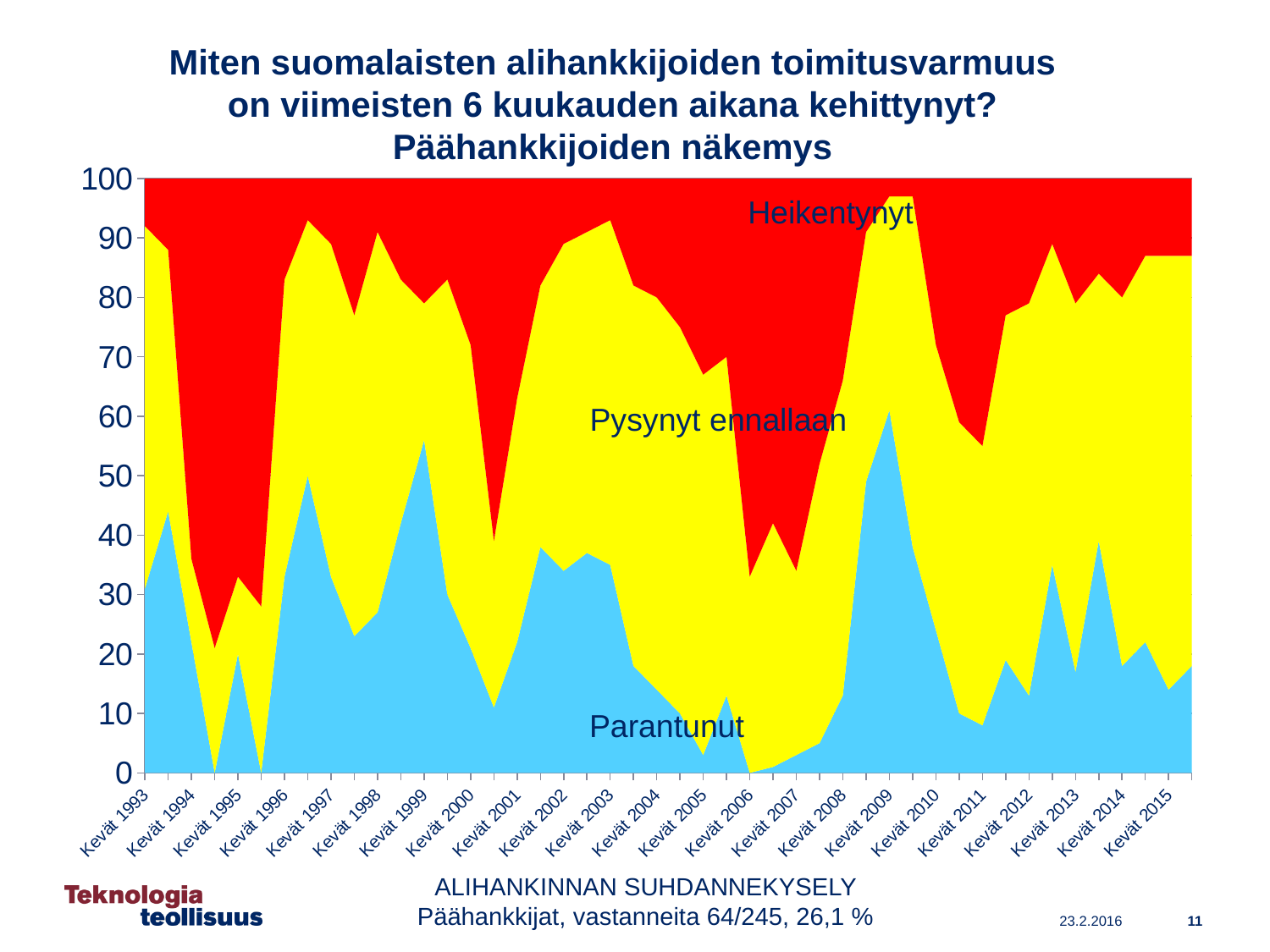
Is the value for Parantunut at Kevät 2006 greater or less than 10? less Which series is at the bottom of the stacked area chart? Parantunut Is the value for Parantunut at Kevät 2014 greater or less than 30? less Is the value for Parantunut at Kevät 2009 greater or less than 50? greater How many years are labelled on the x axis of the chart? 23 Which is larger, the Parantunut value at Kevät 1997 or at Kevät 2011? Kevät 1997 Which series is drawn in red in the chart? Heikentynyt Which is larger, the Parantunut value at Kevät 2009 or at Kevät 2006? Kevät 2009 What kind of chart is shown on the slide? Stacked area chart How many series are shown in the chart? 3